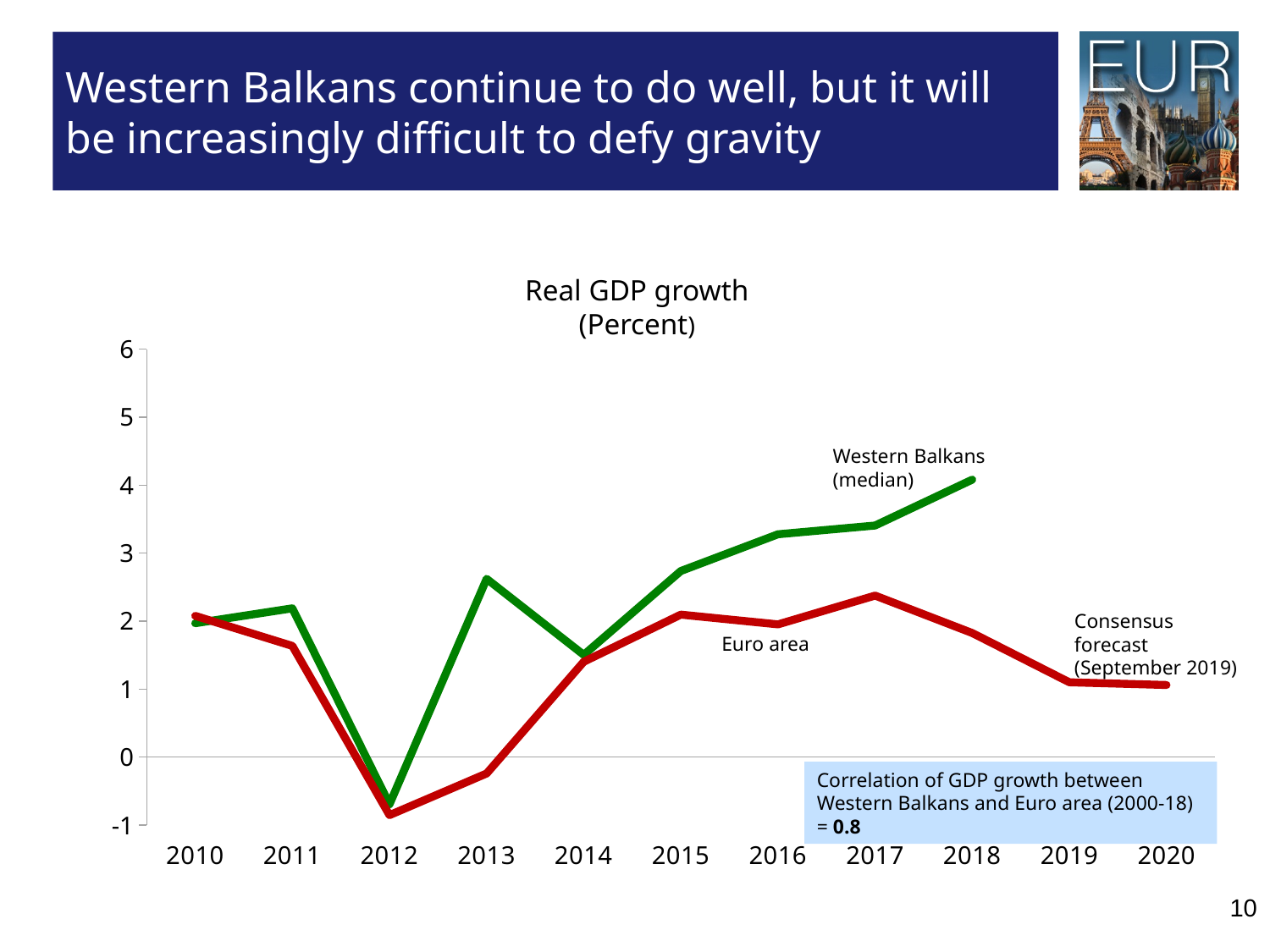
How many years are shown on the x axis of the chart? 11 How many series are plotted on the chart? 2 Is the value for the Euro area in 2012 greater or less than 0? less Is the value for Western Balkans (median) in 2016 greater or less than 3? greater In which year does the Euro area series reach its lowest value? 2012 What correlation of GDP growth between Western Balkans and Euro area (2000-18) is stated on the slide? 0.8 What is the title of the chart? Real GDP growth (Percent) In which year does the Western Balkans (median) series reach its highest value? 2018 What kind of chart is shown on the slide? Line chart Is the value for the Euro area in 2017 greater or less than 2? greater Does the Western Balkans (median) series rise or fall from 2014 to 2018? Rise In 2018, which series has the higher value, Western Balkans (median) or Euro area? Western Balkans (median)